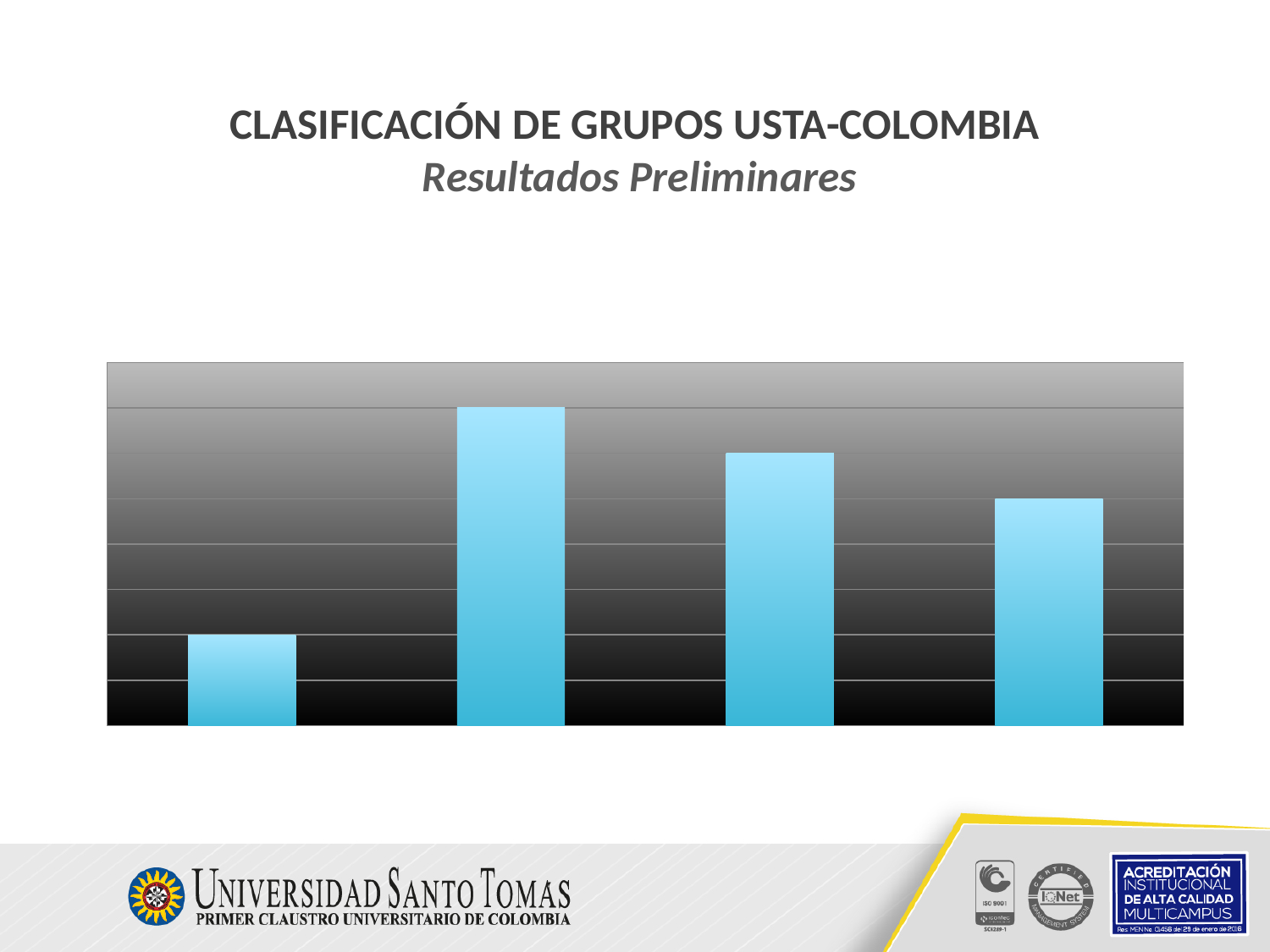
Which bar is the tallest in the chart, counting from the left? the second bar How many bars does the chart show? 4 Which bar is the shortest in the chart, counting from the left? the first bar Is the first bar from the left taller or shorter than the third bar? shorter Do the bar heights rise or fall from the second bar to the fourth bar? fall What kind of chart is shown on the slide? bar chart Does the chart display a legend? No Is the third bar from the left taller or shorter than the fourth bar? taller What colour are the bars in the chart? light blue